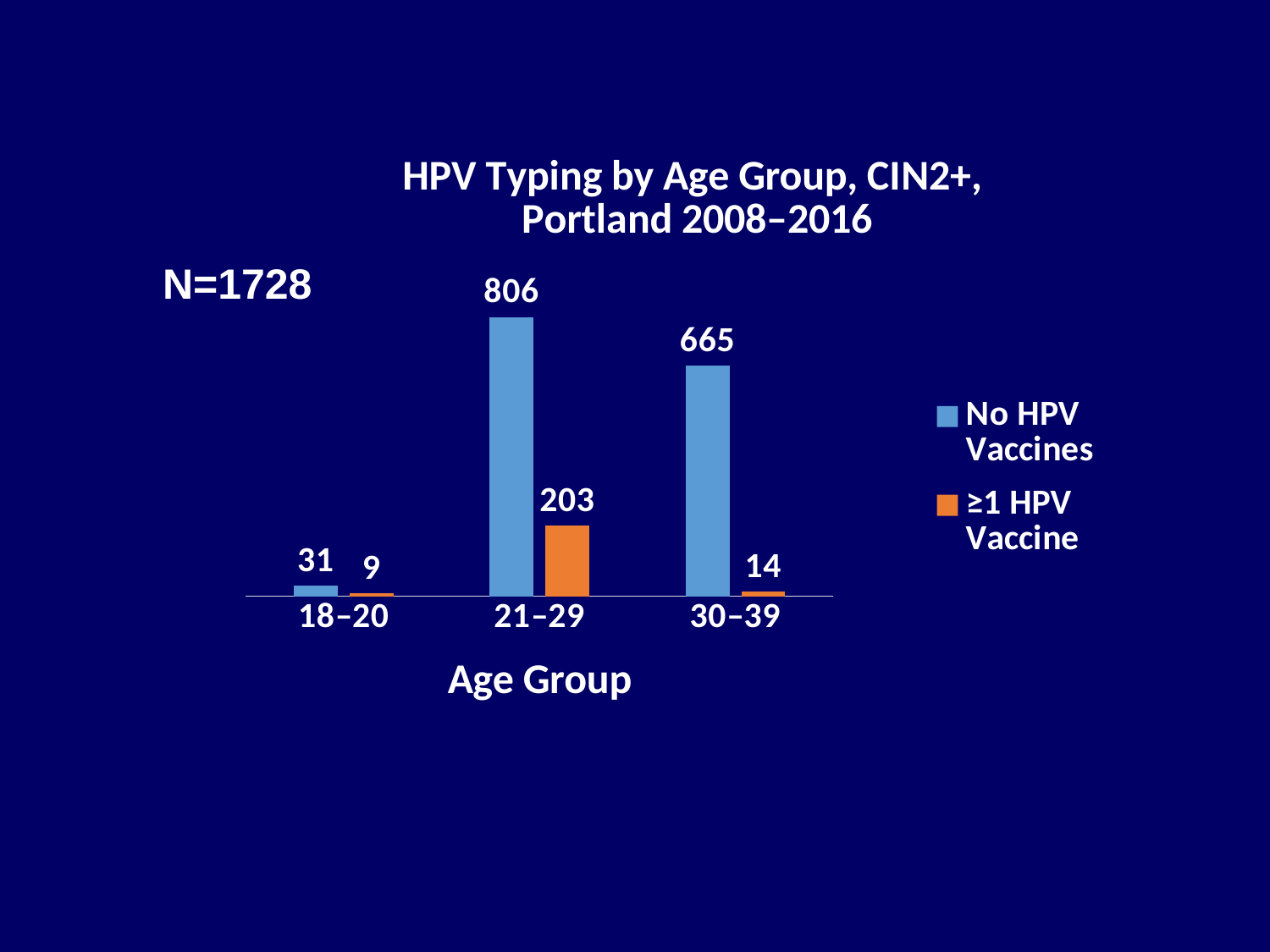
What kind of chart is shown on the slide? Bar chart Which is larger: the ≥1 HPV Vaccine value for 21–29 or for 30–39? 21–29 What is the difference between the No HPV Vaccines values for the 21–29 and 30–39 age groups? 141 What is the value for ≥1 HPV Vaccine in the 18–20 age group? 9 What is the value for No HPV Vaccines in the 21–29 age group? 806 Which age group has the lowest value for ≥1 HPV Vaccine? 18–20 What is the difference between the No HPV Vaccines and ≥1 HPV Vaccine values in the 21–29 age group? 603 How many age groups are shown on the x axis? 3 What is the title of the chart? HPV Typing by Age Group, CIN2+, Portland 2008–2016 Which age group has the highest value for No HPV Vaccines? 21–29 How many series does the legend list? 2 What is the value for ≥1 HPV Vaccine in the 30–39 age group? 14